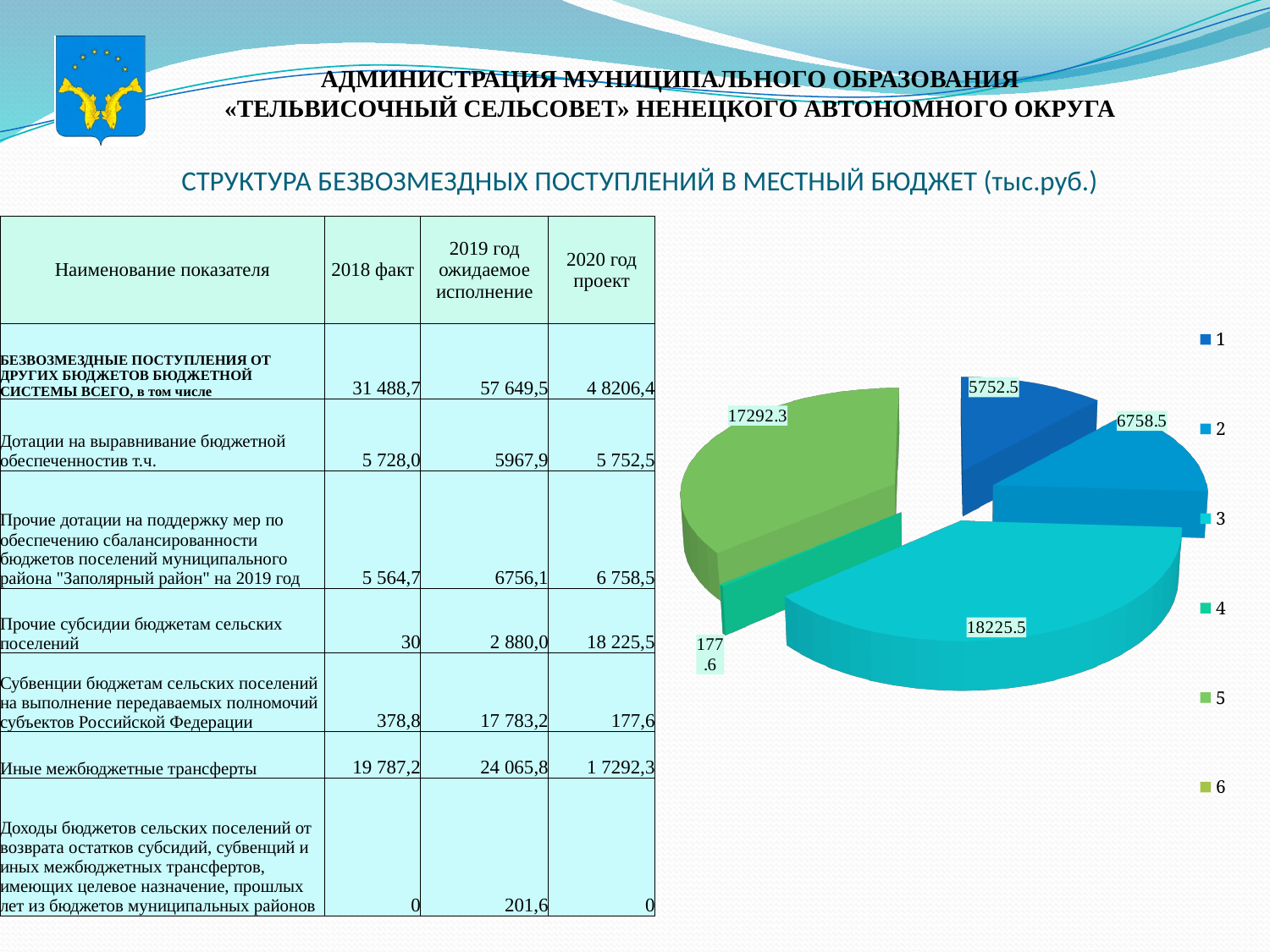
How many entries does the legend of the pie chart list? 6 What value is printed on the dark blue slice (legend entry 1) of the pie chart? 5752.5 What is the difference between the slice labelled 18225.5 and the slice labelled 17292.3 on the pie chart? 933.2 What value is printed on the slice for legend entry 2 of the pie chart? 6758.5 How many data labels are printed on the pie chart? 5 What value is printed on the largest slice of the pie chart? 18225.5 What value is printed on the smallest labelled slice of the pie chart? 177.6 What kind of chart is shown on the right side of the slide? pie chart Which slice of the pie chart is larger: the one labelled 18225.5 or the one labelled 17292.3? 18225.5 What value is printed on the green slice (legend entry 5) of the pie chart? 17292.3 What is the difference between the slice labelled 6758.5 and the slice labelled 5752.5 on the pie chart? 1006 Which legend entry corresponds to the largest slice of the pie chart? 3